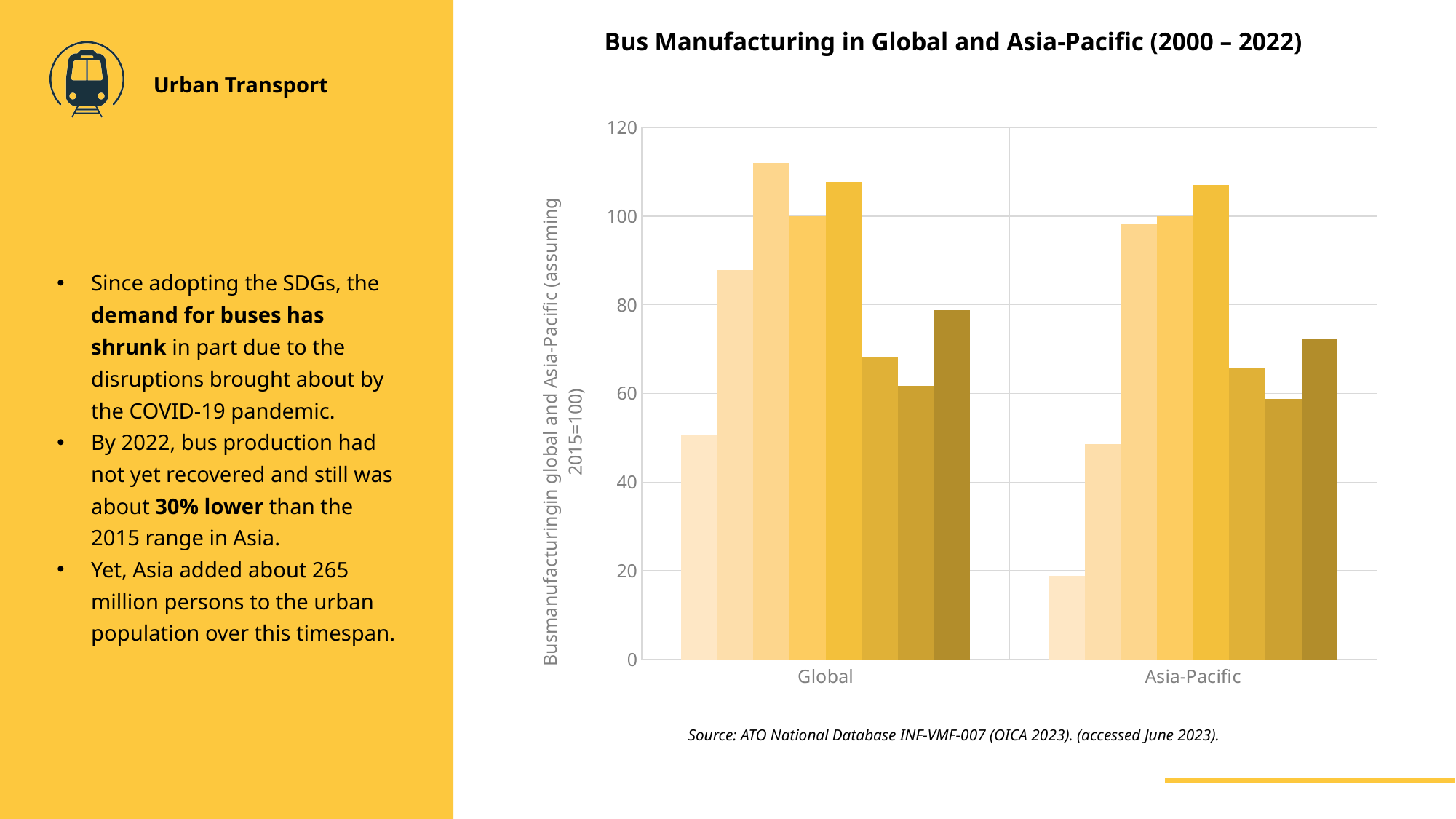
What is the highest value shown on the y axis of the chart? 120 How many bars are plotted in the Global group? 8 Is the value of the last (darkest) bar in the Asia-Pacific group greater or less than 80? less Which is larger: the first (lightest) bar in the Global group or the first (lightest) bar in the Asia-Pacific group? Global Is the tallest bar in the Global group greater or less than 100? greater Is the value of the first (lightest) bar in the Global group greater or less than 60? less What kind of chart is shown on the slide? Bar chart How many categories are shown on the x axis of the chart? 2 What is the title of the chart? Bus Manufacturing in Global and Asia-Pacific (2000 – 2022) Which bar in the Asia-Pacific group has the lowest value? The first (lightest) bar